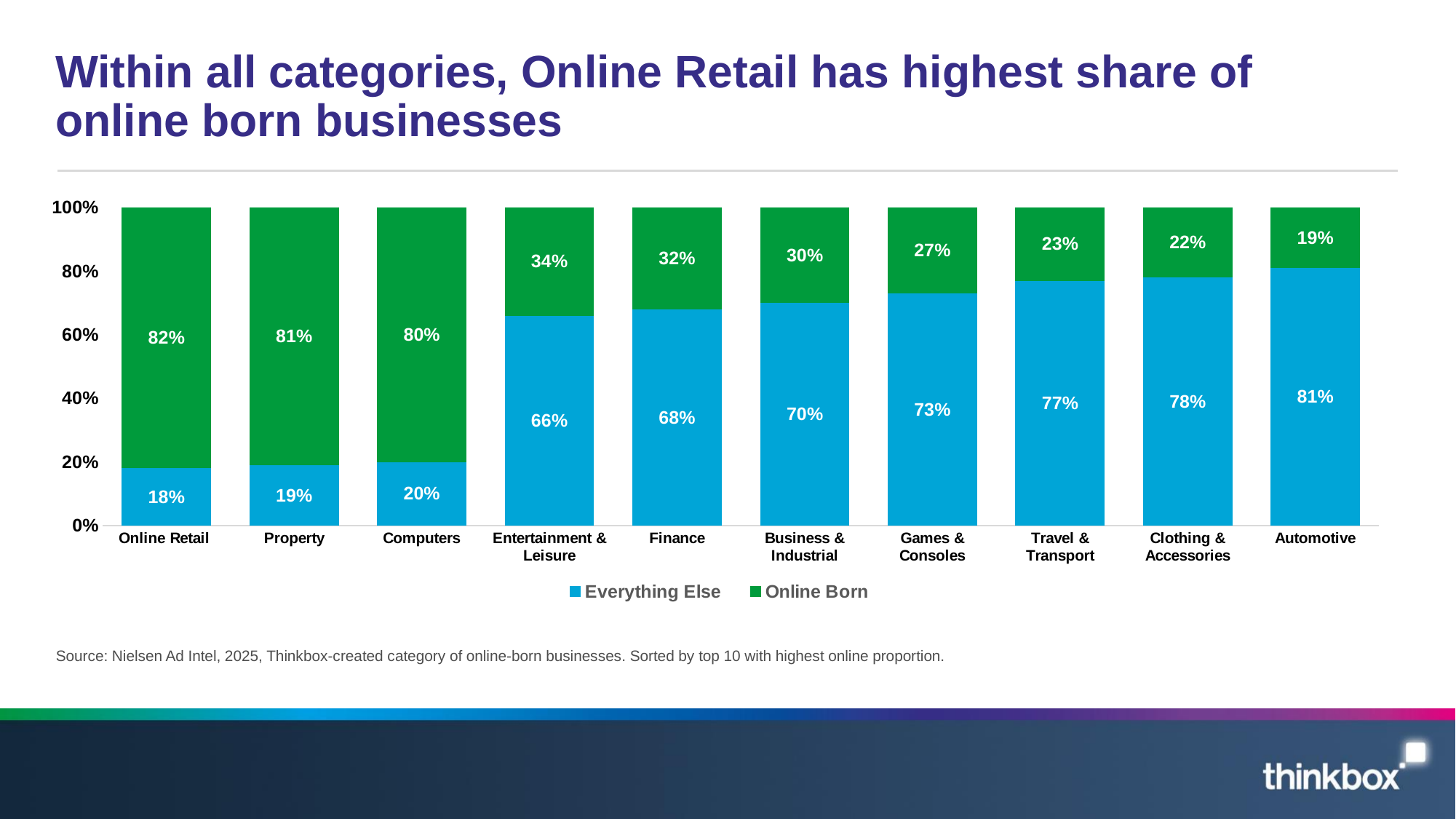
Which is larger: the Everything Else share for Games & Consoles or for Business & Industrial? Games & Consoles What is the Online Born share for Travel & Transport? 23% How many categories are shown on the x axis? 10 What is the Everything Else share for Finance? 68% Which colour represents the Online Born series? Green Which category has the lowest Online Born share? Automotive What is the Online Born share for Online Retail? 82% Which category has the highest Online Born share? Online Retail What kind of chart is shown on the slide? Stacked bar chart How many series does the legend list? 2 What is the difference between the Online Born share for Computers and for Entertainment & Leisure? 46 percentage points Does the Online Born share rise or fall moving from left to right along the x axis? Fall